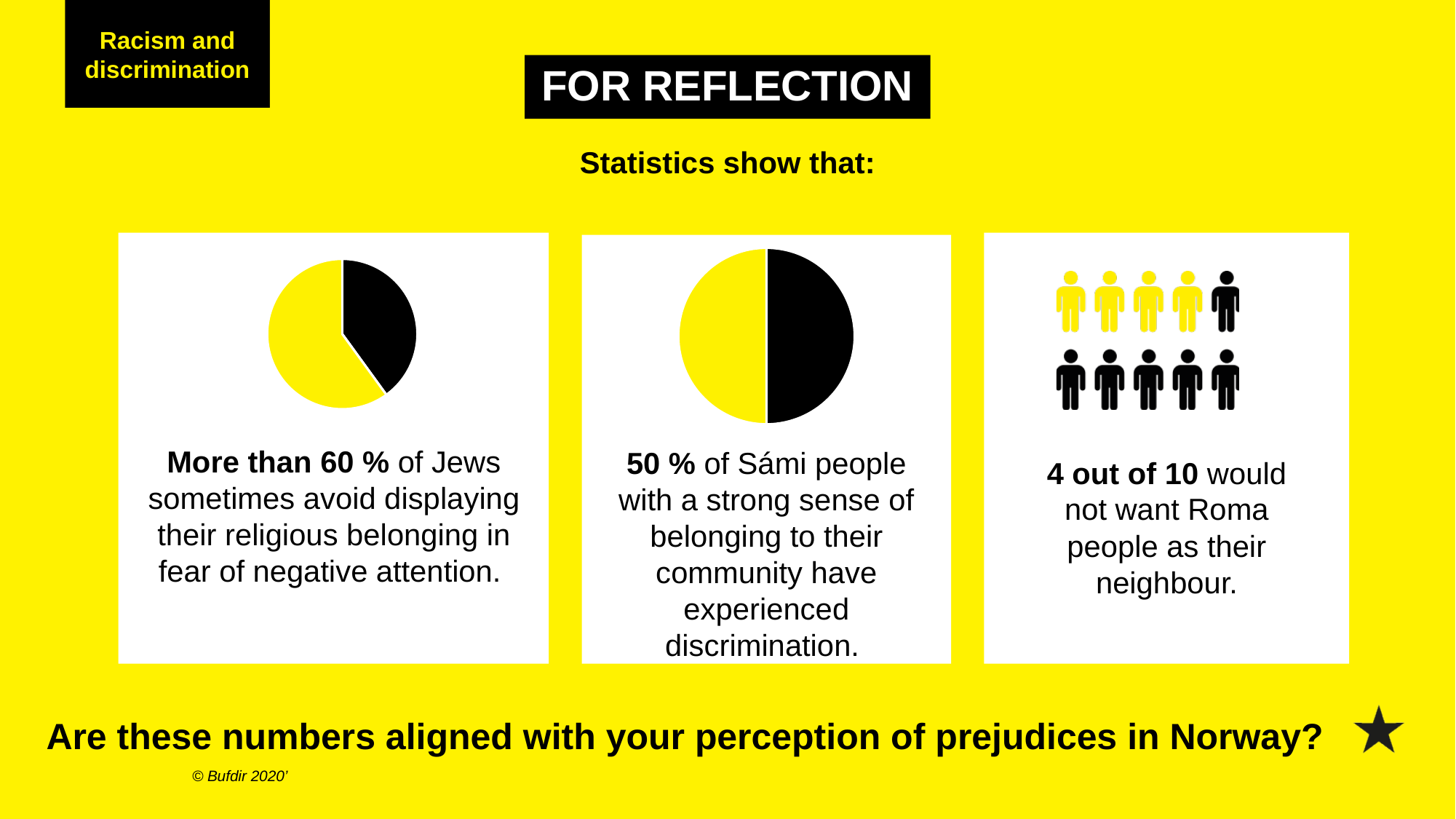
How many pie charts are shown on the slide? 2 According to the left panel, what share of Jews sometimes avoid displaying their religious belonging in fear of negative attention? More than 60 % What kind of chart is shown in the left panel about Jews? pie chart What kind of chart is shown in the middle panel about Sámi people? pie chart In the middle pie chart about Sámi people, are the yellow and black slices equal in size? yes In the right panel pictogram, how many person icons are coloured yellow? 4 In the right panel pictogram, how many person icons are shown in total? 10 According to the right panel, how many out of 10 would not want Roma people as their neighbour? 4 out of 10 What is the heading shown in the black box at the top of the slide? FOR REFLECTION According to the middle panel, what share of Sámi people with a strong sense of belonging to their community have experienced discrimination? 50 % In the left pie chart about Jews, which slice is larger, the yellow one or the black one? yellow